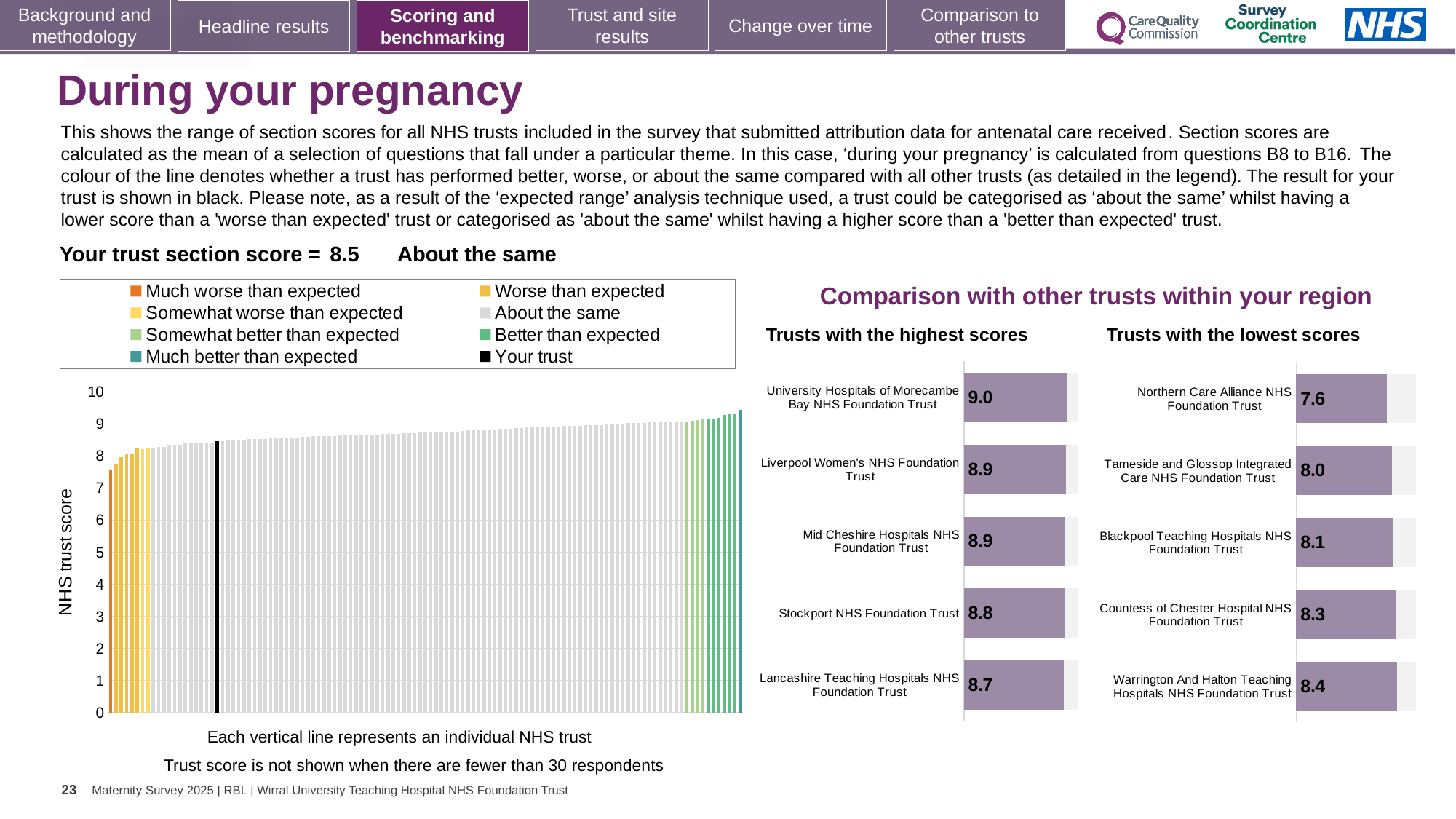
What is the label of the vertical axis on the left-hand chart? NHS trust score In the 'Trusts with the lowest scores' chart, what is the difference between the scores of Warrington And Halton Teaching Hospitals NHS Foundation Trust and Northern Care Alliance NHS Foundation Trust? 0.8 In the 'Trusts with the highest scores' chart, which has the higher score: Lancashire Teaching Hospitals NHS Foundation Trust or Liverpool Women's NHS Foundation Trust? Liverpool Women's NHS Foundation Trust In the 'Trusts with the highest scores' chart, what is the score for Stockport NHS Foundation Trust? 8.8 How many trusts are listed in the 'Trusts with the lowest scores' chart? 5 What type of chart is the 'NHS trust score' chart on the left of the slide? Bar chart In the 'Trusts with the lowest scores' chart, which trust has the lowest score? Northern Care Alliance NHS Foundation Trust In the 'Trusts with the lowest scores' chart, what is the score for Northern Care Alliance NHS Foundation Trust? 7.6 In the 'Trusts with the lowest scores' chart, what is the score for Blackpool Teaching Hospitals NHS Foundation Trust? 8.1 In the 'Trusts with the highest scores' chart, what is the score for University Hospitals of Morecambe Bay NHS Foundation Trust? 9.0 In the 'Trusts with the highest scores' chart, which trust has the highest score? University Hospitals of Morecambe Bay NHS Foundation Trust How many entries does the legend of the 'NHS trust score' chart list? 8